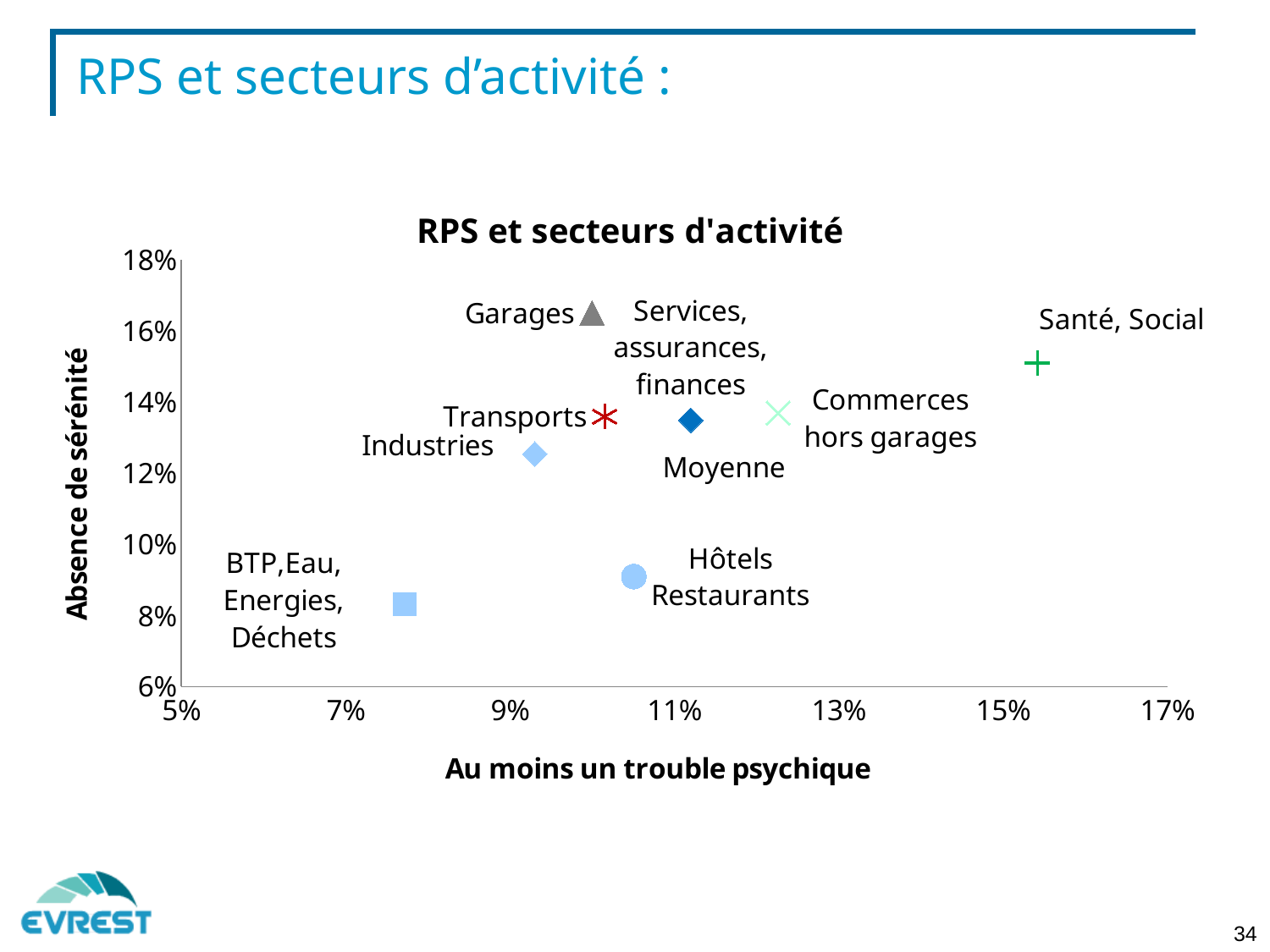
Which sector has the highest value on the horizontal axis (Au moins un trouble psychique)? Santé, Social What kind of chart is shown on the slide? Scatter chart Which sector has the lowest value on the horizontal axis (Au moins un trouble psychique)? BTP, Eau, Energies, Déchets Is the vertical-axis value (Absence de sérénité) for Garages greater or less than 16%? greater Is the horizontal-axis value (Au moins un trouble psychique) for Industries greater or less than 11%? less What is the title of the horizontal axis of the chart? Au moins un trouble psychique Is the horizontal-axis value (Au moins un trouble psychique) for Santé, Social greater or less than 13%? greater Which sector has the lowest value on the vertical axis (Absence de sérénité)? BTP, Eau, Energies, Déchets Which has the higher vertical-axis value (Absence de sérénité): Garages or Industries? Garages Which has the higher horizontal-axis value (Au moins un trouble psychique): Santé, Social or Hôtels Restaurants? Santé, Social Which sector has the highest value on the vertical axis (Absence de sérénité)? Garages